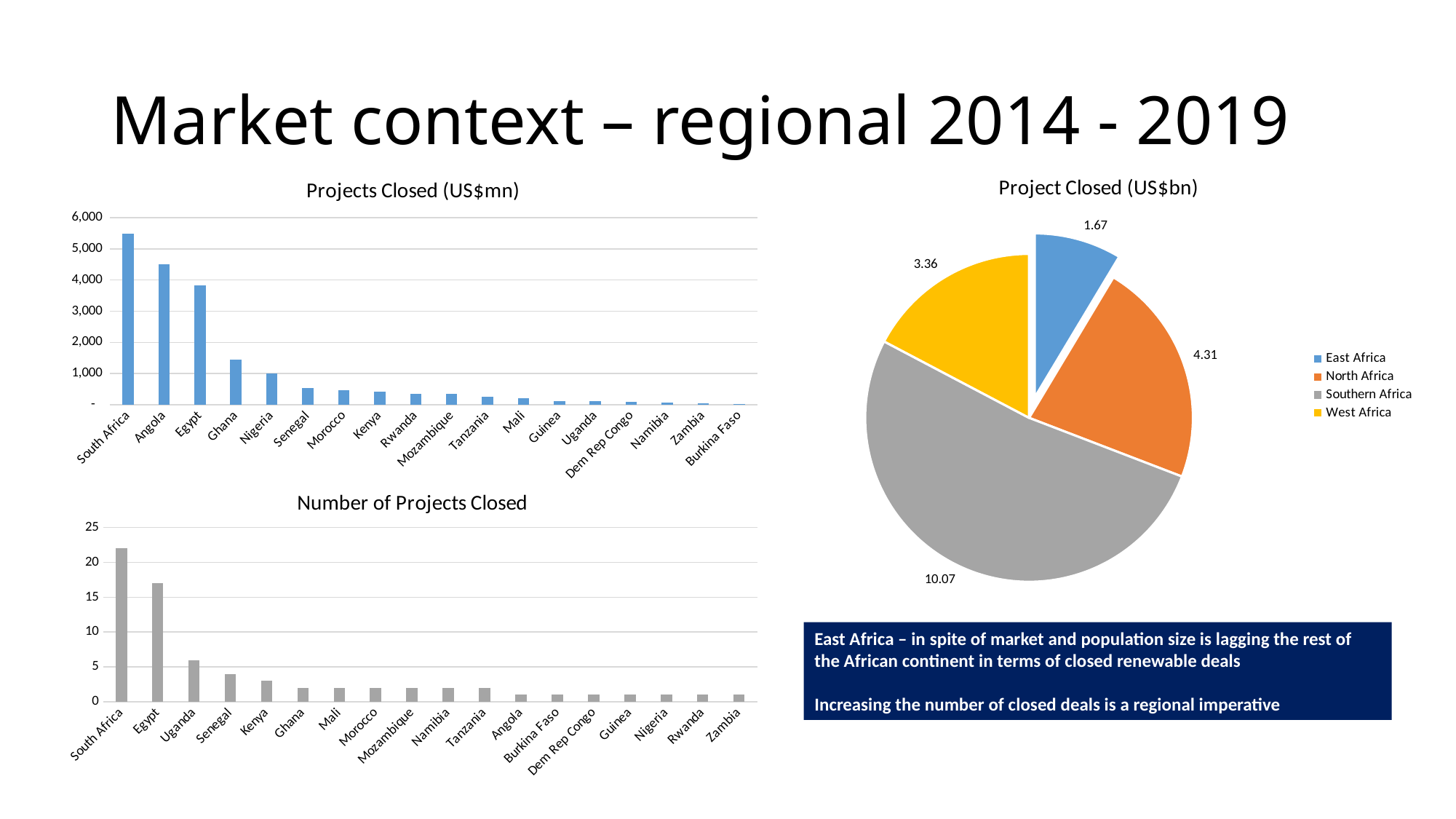
In the 'Projects Closed (US$mn)' chart, is the value for Angola greater or less than 4,000? greater In the 'Project Closed (US$bn)' pie chart, what is the value for Southern Africa? 10.07 In the 'Number of Projects Closed' chart, is the value for Egypt greater or less than 15? greater In the 'Project Closed (US$bn)' pie chart, what is the difference between the North Africa and West Africa values? 0.95 In the 'Projects Closed (US$mn)' chart, is the value for Ghana greater or less than 2,000? less In the 'Project Closed (US$bn)' pie chart, what is the value for East Africa? 1.67 How many regions does the legend of the 'Project Closed (US$bn)' pie chart list? 4 In the 'Project Closed (US$bn)' pie chart, which region has the largest slice? Southern Africa What kind of chart is the 'Number of Projects Closed' chart? bar chart In the 'Projects Closed (US$mn)' chart, which country has the highest value? South Africa How many countries are shown in the 'Number of Projects Closed' chart? 18 In the 'Project Closed (US$bn)' pie chart, which region has the smallest slice? East Africa